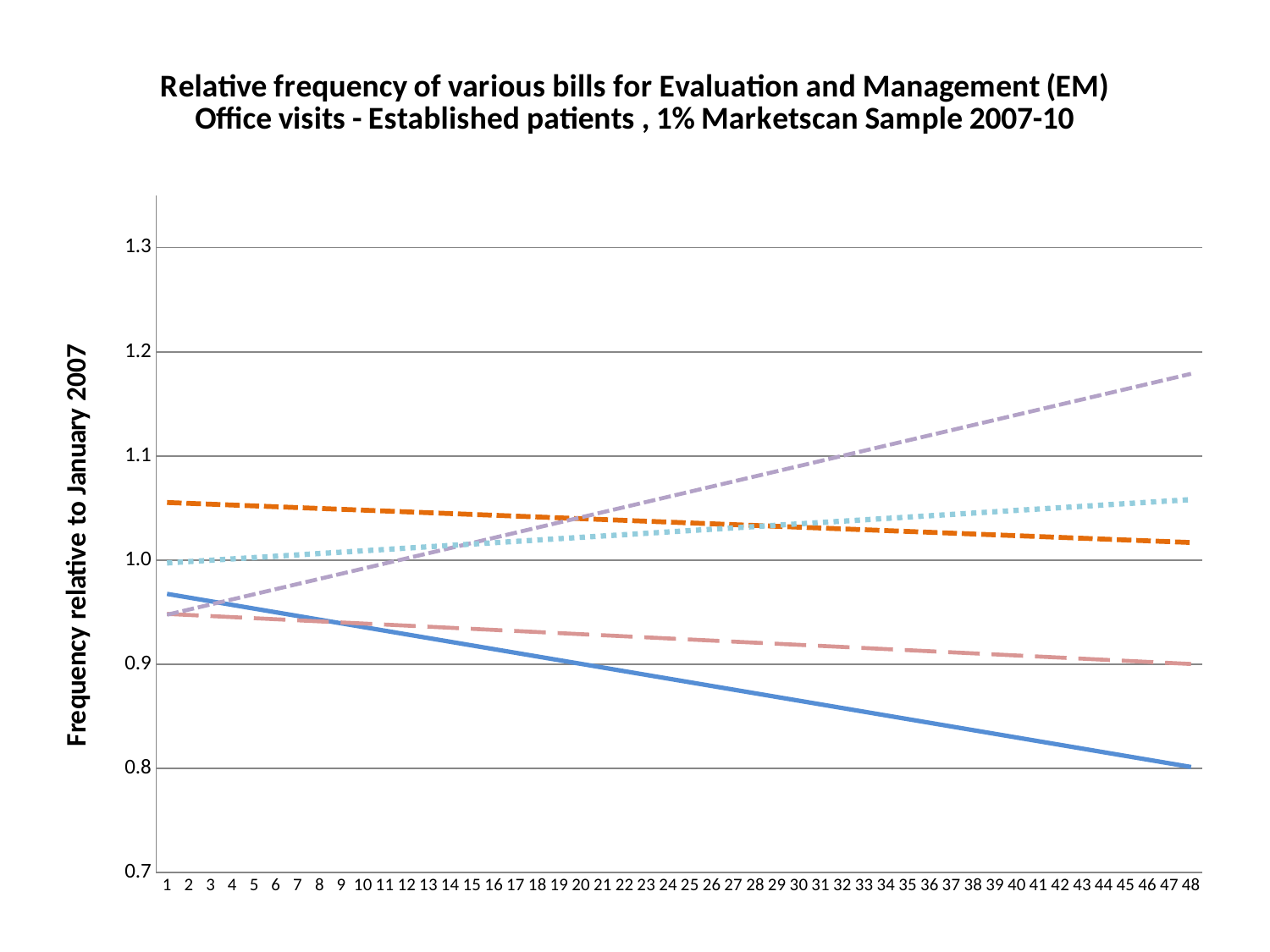
What is the label on the y axis? Frequency relative to January 2007 How many lines are plotted on the chart? 5 Is the value of the purple dashed line at point 48 greater or less than 1.1? greater What kind of chart is shown on the slide? line chart Which line has the lowest value at point 48? the solid blue line How many points are labelled along the x axis? 48 Does the orange dashed line rise or fall from point 1 to point 48? fall Which line has the highest value at point 48? the purple dashed line Does the solid blue line rise or fall from point 1 to point 48? fall Is the value of the solid blue line at point 1 greater or less than 1.0? less Does the purple dashed line rise or fall from point 1 to point 48? rise At point 1, which is larger: the orange dashed line or the solid blue line? the orange dashed line